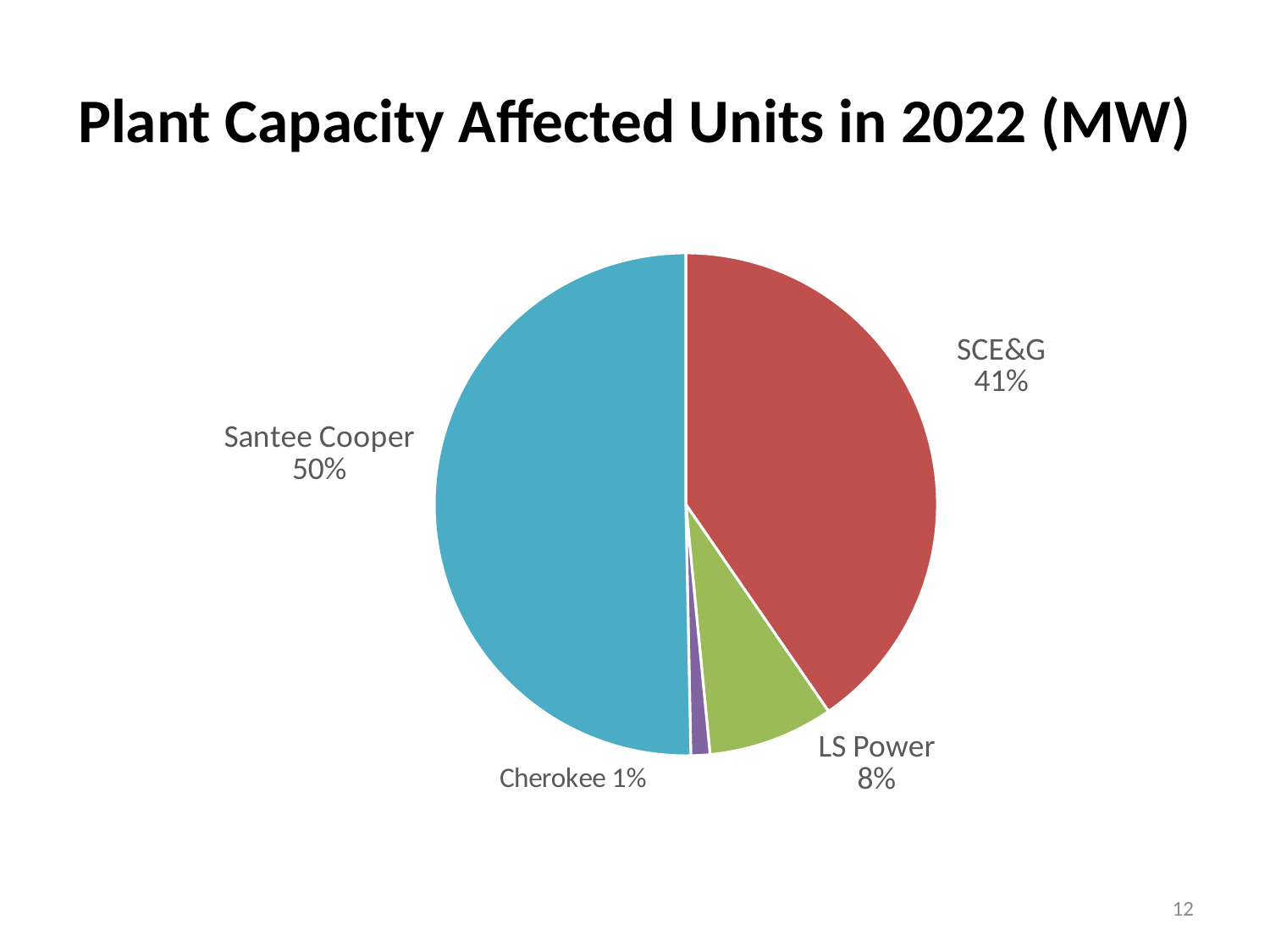
What is the title of the chart? Plant Capacity Affected Units in 2022 (MW) Which slice is the largest? Santee Cooper What share of the pie does SCE&G hold? 41% Which is larger, the SCE&G slice or the LS Power slice? SCE&G How many slices does the pie chart have? 4 What share of the pie does Cherokee hold? 1% What share of the pie does Santee Cooper hold? 50% What kind of chart is shown on the slide? Pie chart What is the difference in percentage points between LS Power and Cherokee? 7 What is the difference in percentage points between Santee Cooper and SCE&G? 9 Which slice is the smallest? Cherokee